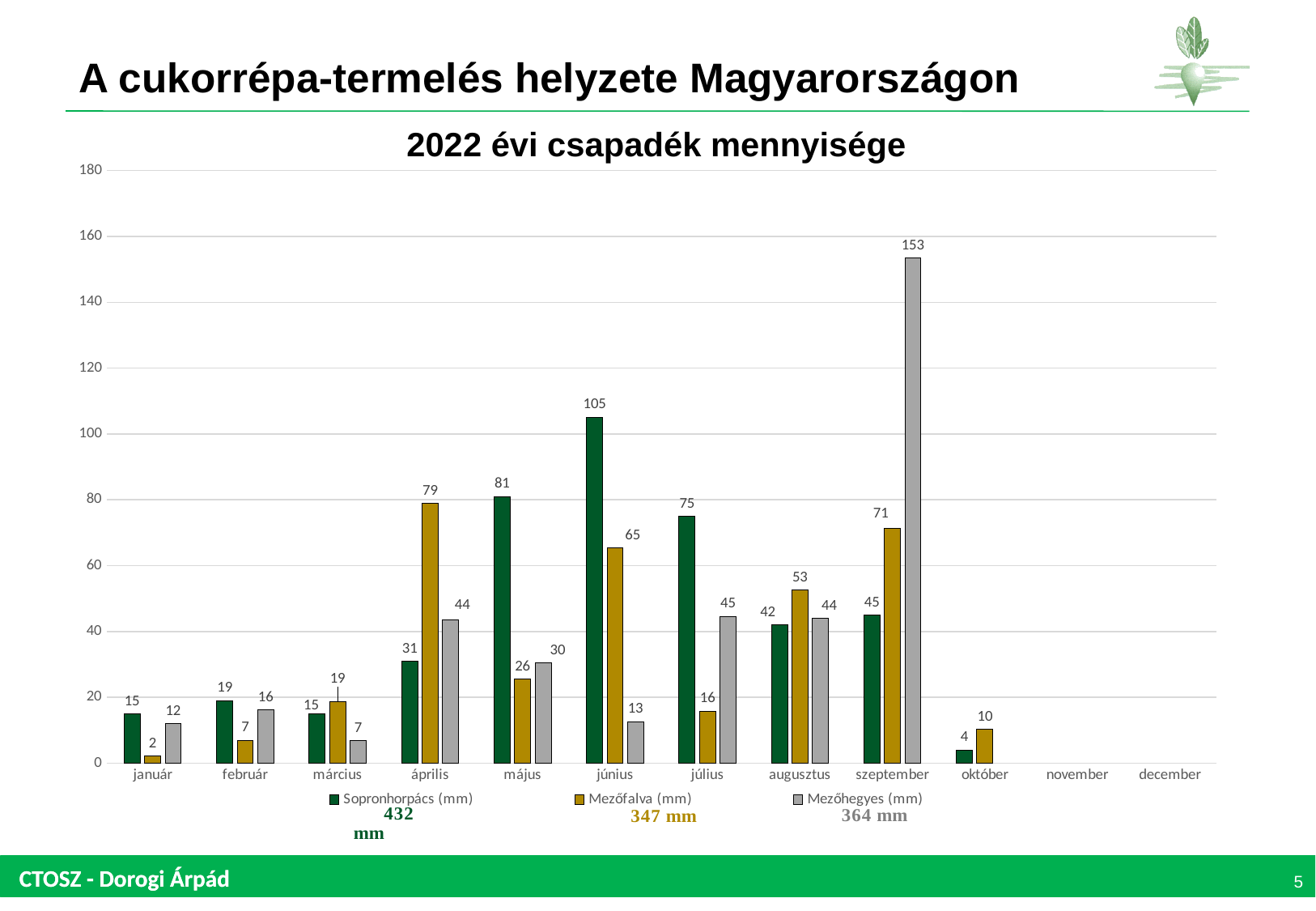
In which month is the Sopronhorpács (mm) value highest? június In május, which is larger: Sopronhorpács (mm) or Mezőfalva (mm)? Sopronhorpács (mm) What is the value for Sopronhorpács (mm) in június? 105 What kind of chart is shown on the slide? bar chart How many months are shown on the x axis? 12 How many series does the legend list? 3 What is the value for Mezőfalva (mm) in október? 10 Is the value for Mezőhegyes (mm) in szeptember greater or less than 140? greater In április, how much larger is the Mezőfalva (mm) value than the Sopronhorpács (mm) value? 48 In which month is the Mezőfalva (mm) value lowest? január What annual total is printed under the Sopronhorpács (mm) legend entry? 432 mm What is the value for Mezőhegyes (mm) in szeptember? 153